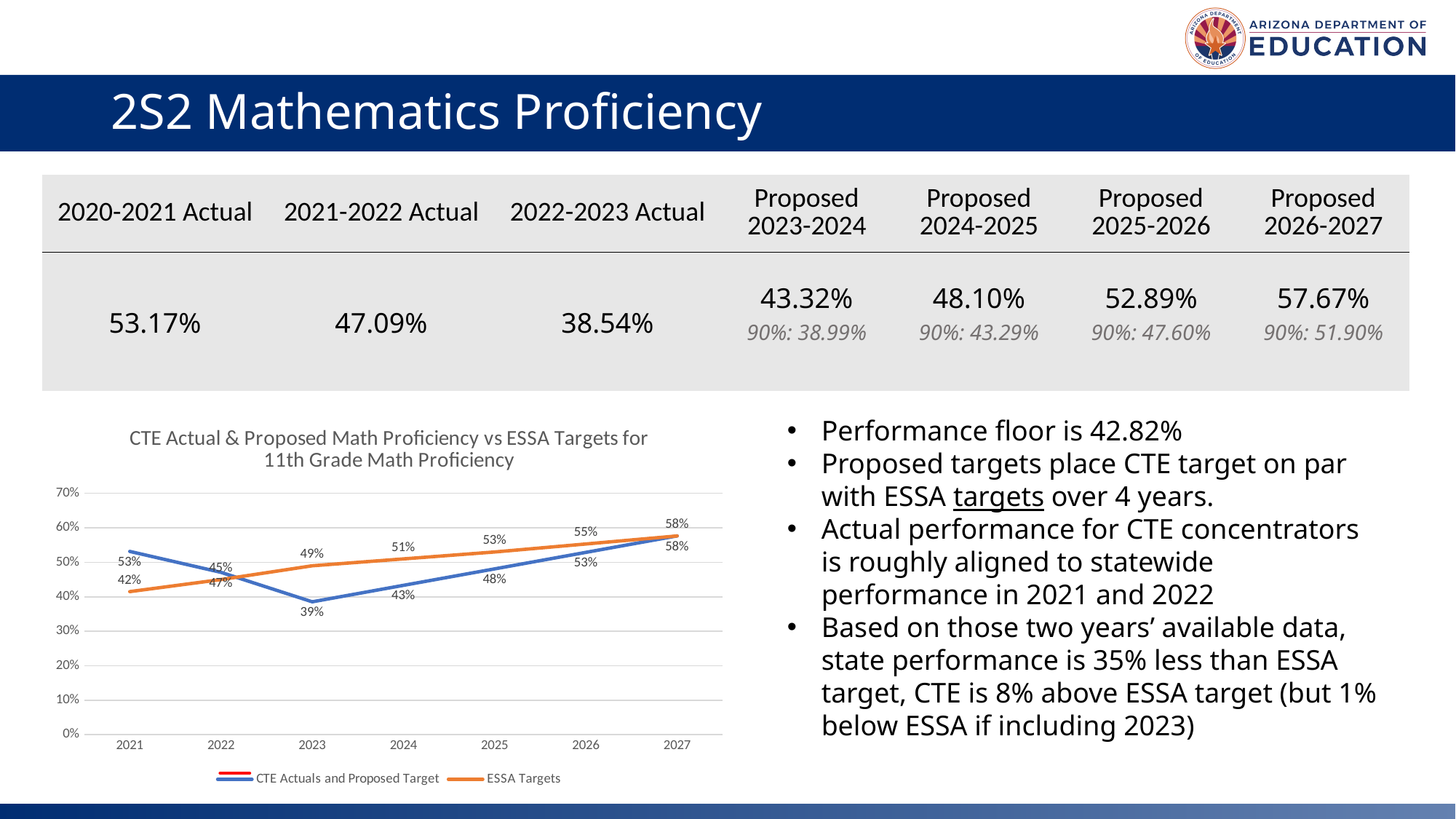
What is the difference between the ESSA Targets value and the CTE Actuals and Proposed Target value in 2023? 10% Do the ESSA Targets values rise or fall from 2021 to 2027? Rise In which year is the ESSA Targets value highest? 2027 In which year is the CTE Actuals and Proposed Target value lowest? 2023 In 2021, which series has the larger value, CTE Actuals and Proposed Target or ESSA Targets? CTE Actuals and Proposed Target What type of chart is shown on the slide? Line chart What is the ESSA Targets value for 2025? 53% What is the CTE Actuals and Proposed Target value for 2023? 39% What is the ESSA Targets value for 2021? 42% How many years are plotted on the x axis of the chart? 7 What is the title of the chart? CTE Actual & Proposed Math Proficiency vs ESSA Targets for 11th Grade Math Proficiency How many series does the chart legend list? 2